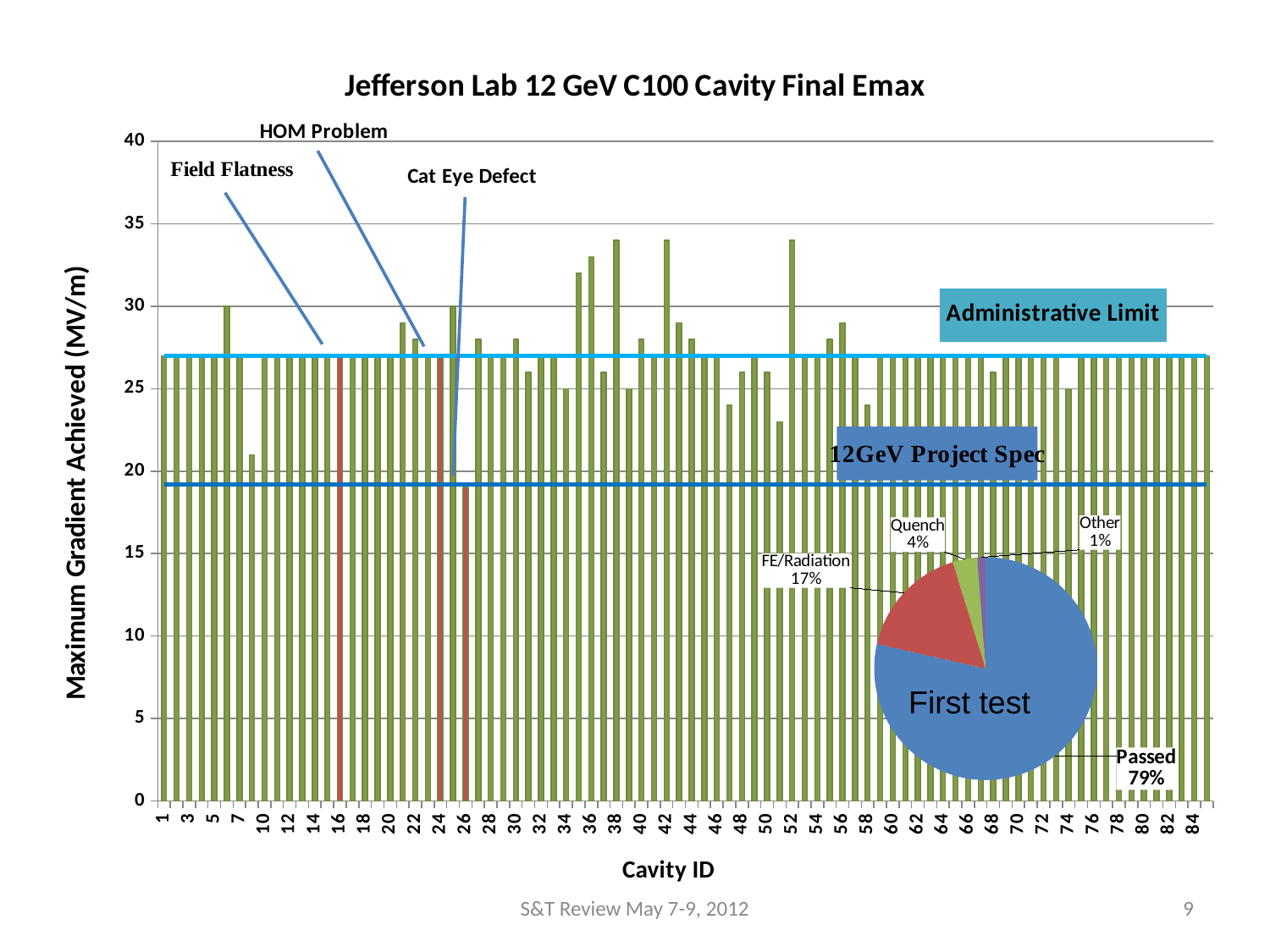
What is the y-axis label of the bar chart? Maximum Gradient Achieved (MV/m) In the 'First test' pie chart, which slice is the largest? Passed In the 'First test' pie chart, what share is Quench? 4% How many slices does the 'First test' pie chart have? 4 In the 'First test' pie chart, what share of cavities Passed? 79% In the bar chart, is the value for Cavity ID 38 greater or less than 30? greater In the 'First test' pie chart, how many percentage points larger is Passed than FE/Radiation? 62% What kind of chart is the main chart titled 'Jefferson Lab 12 GeV C100 Cavity Final Emax'? bar chart In the 'First test' pie chart, what share is FE/Radiation? 17% What kind of chart is the inset chart labelled 'First test'? pie chart In the 'First test' pie chart, which slice is the smallest? Other